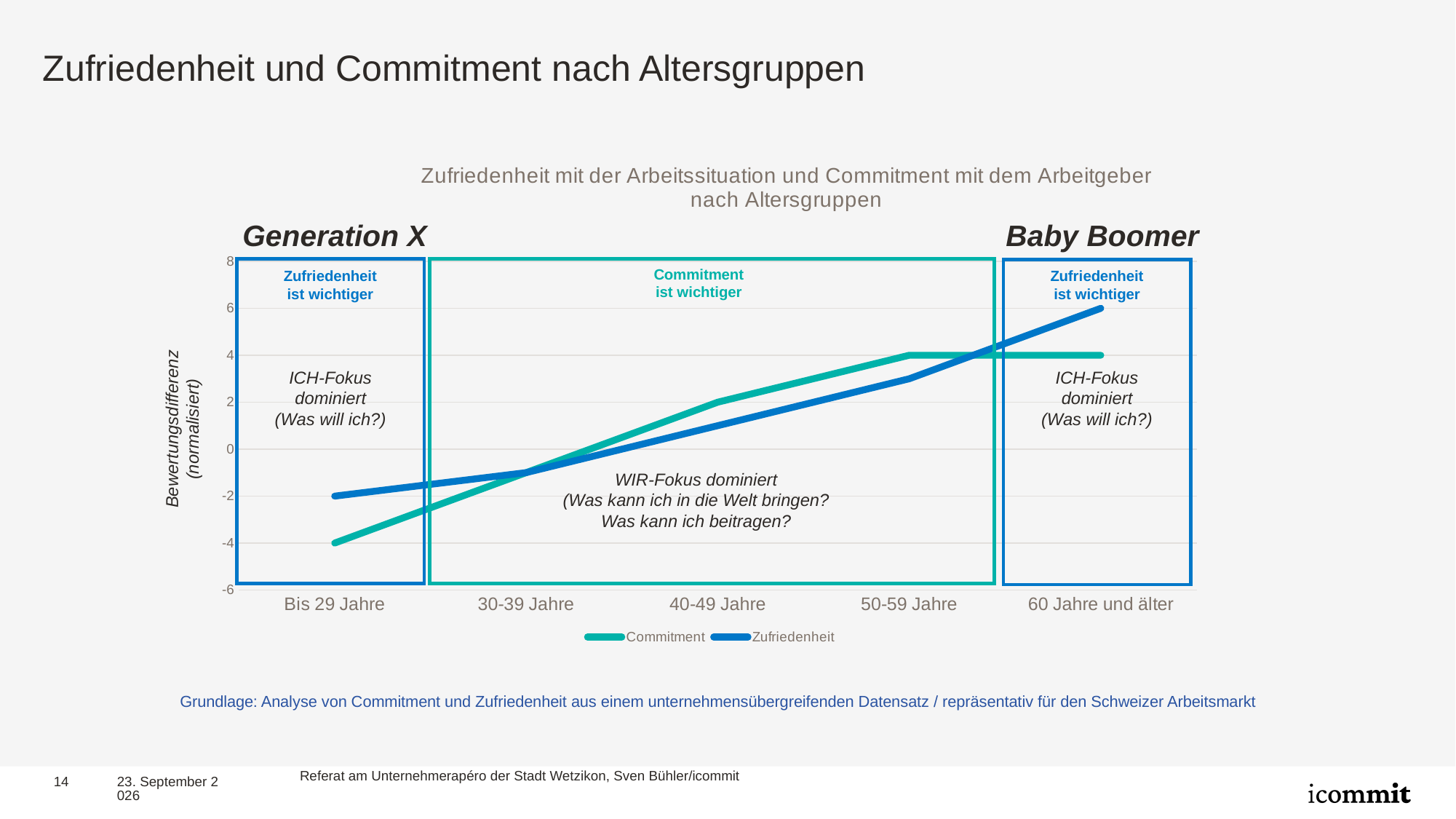
How many age groups are shown on the x axis of the chart? 5 How many series does the chart legend list? 2 What is the Commitment value for the age group 'Bis 29 Jahre'? -4 What is the Commitment value for the age group '40-49 Jahre'? 2 For which age group is the Zufriedenheit value highest? 60 Jahre und älter Is the Zufriedenheit value for '50-59 Jahre' greater or less than 2? greater Do the Commitment values generally rise or fall from 'Bis 29 Jahre' to '50-59 Jahre'? Rise What is the difference between Zufriedenheit and Commitment for the age group '60 Jahre und älter'? 2 What is the Zufriedenheit value for the age group '60 Jahre und älter'? 6 What is the Zufriedenheit value for the age group 'Bis 29 Jahre'? -2 What type of chart is shown on the slide? Line chart For which age group is the Commitment value lowest? Bis 29 Jahre